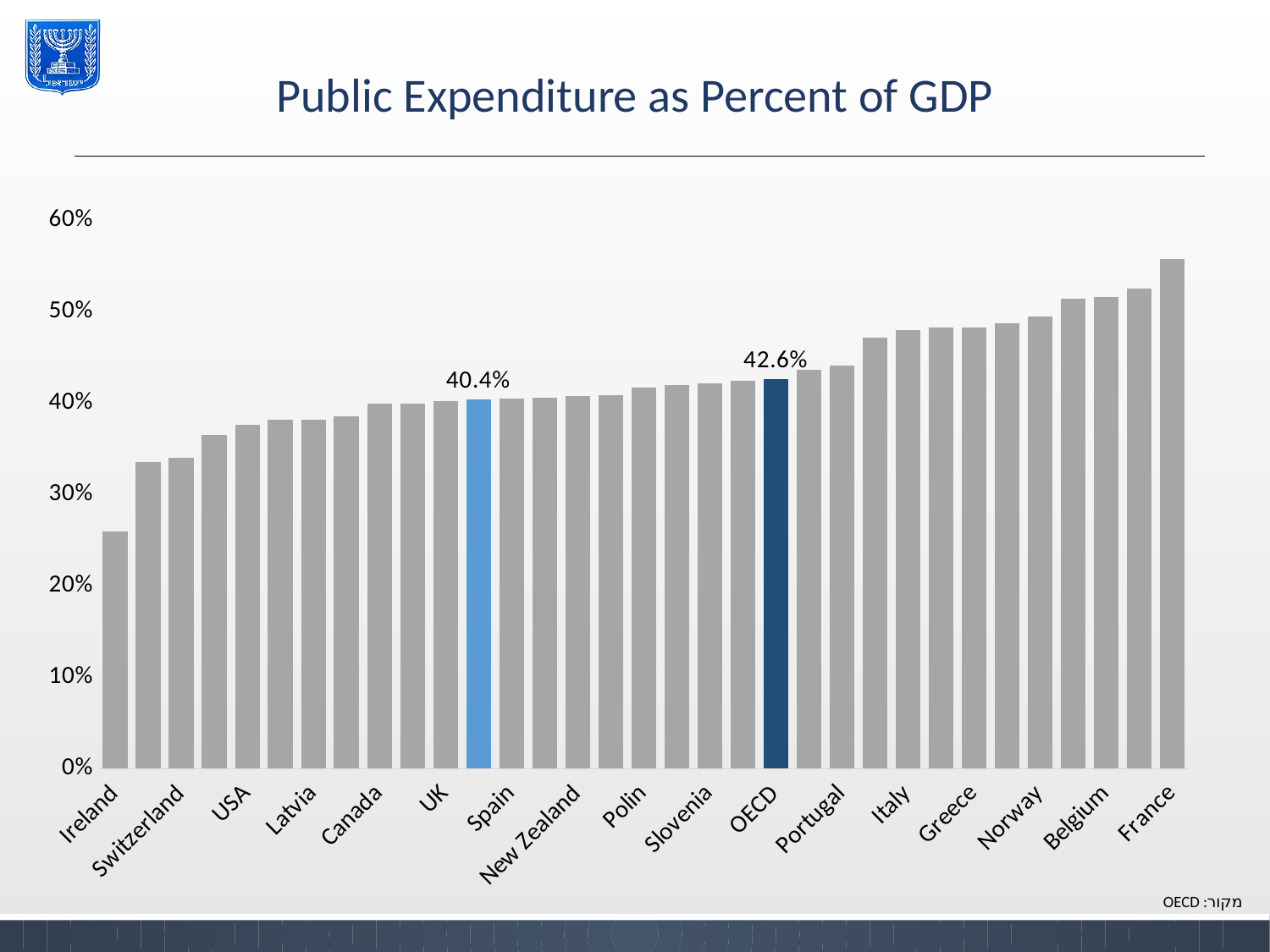
Which is larger, the OECD bar or the light blue bar? OECD Is the value for France greater or less than 50%? greater Do the values rise or fall from left to right along the x axis? rise What kind of chart is shown on the slide? bar chart What value is labelled on the light blue bar? 40.4% Which country has the highest public expenditure as percent of GDP? France What is the title of the chart? Public Expenditure as Percent of GDP What is the difference between the OECD value and the value on the light blue bar? 2.2 percentage points Is the value for Ireland greater or less than 30%? less Which is larger, the value for Italy or the value for USA? Italy What is the value for OECD? 42.6% Which country has the lowest public expenditure as percent of GDP? Ireland